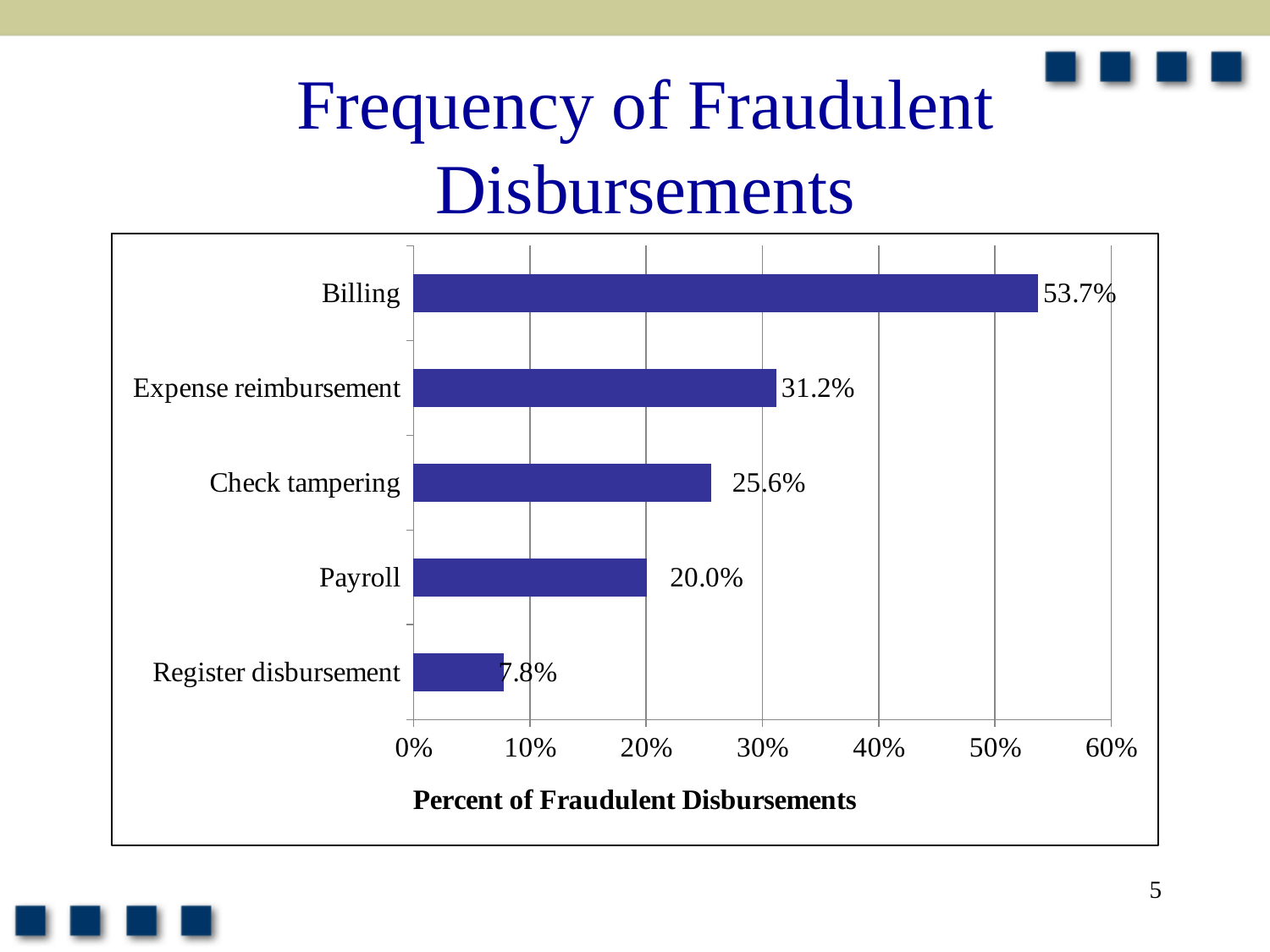
Which category has the highest percent of fraudulent disbursements? Billing Is the value for Expense reimbursement greater or less than 30%? greater Which category has the lowest percent of fraudulent disbursements? Register disbursement What is the value for Register disbursement? 7.8% What is the value for Payroll? 20.0% What is the value for Expense reimbursement? 31.2% What is the difference between the values for Billing and Expense reimbursement? 22.5% What is the value for Billing? 53.7% How many categories are shown in the chart? 5 What is the value for Check tampering? 25.6% What kind of chart is shown on the slide? Bar chart Which is larger, the value for Check tampering or the value for Payroll? Check tampering